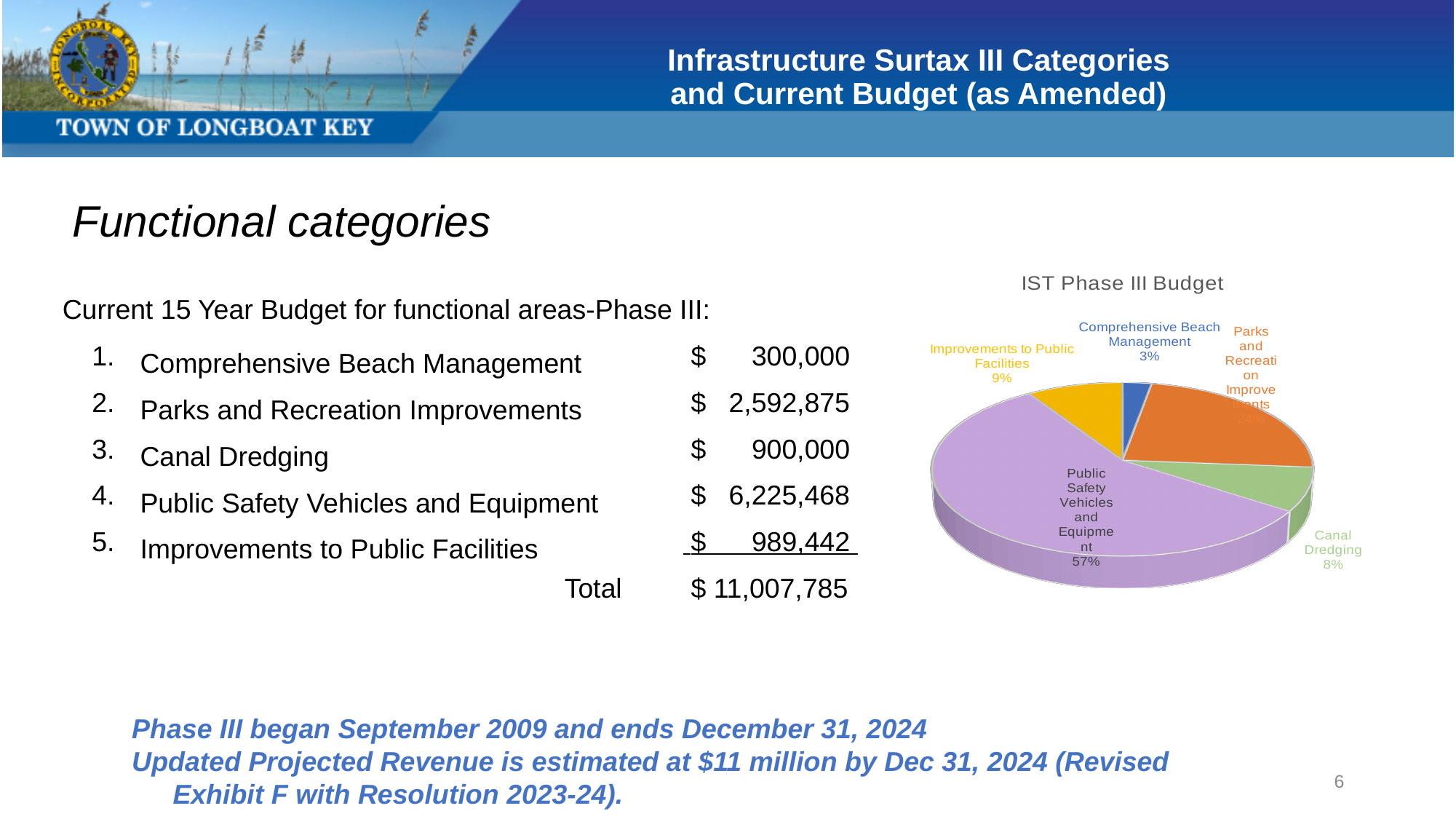
In the IST Phase III Budget pie chart, which has the larger share: Canal Dredging or Improvements to Public Facilities? Improvements to Public Facilities What share of the IST Phase III Budget pie is Public Safety Vehicles and Equipment? 57% What is the title of the pie chart on the slide? IST Phase III Budget What percentage is labelled for Improvements to Public Facilities in the IST Phase III Budget pie chart? 9% Which category has the smallest slice in the IST Phase III Budget pie chart? Comprehensive Beach Management Which category has the largest slice in the IST Phase III Budget pie chart? Public Safety Vehicles and Equipment In the IST Phase III Budget pie chart, how many percentage points larger is the Public Safety Vehicles and Equipment share than the Canal Dredging share? 49 percentage points What percentage is shown for Comprehensive Beach Management in the IST Phase III Budget pie chart? 3% What percentage does the Canal Dredging slice show in the IST Phase III Budget pie chart? 8% What colour is the Public Safety Vehicles and Equipment slice in the IST Phase III Budget pie chart? purple What kind of chart is the IST Phase III Budget chart? pie chart How many slices does the IST Phase III Budget pie chart have? 5